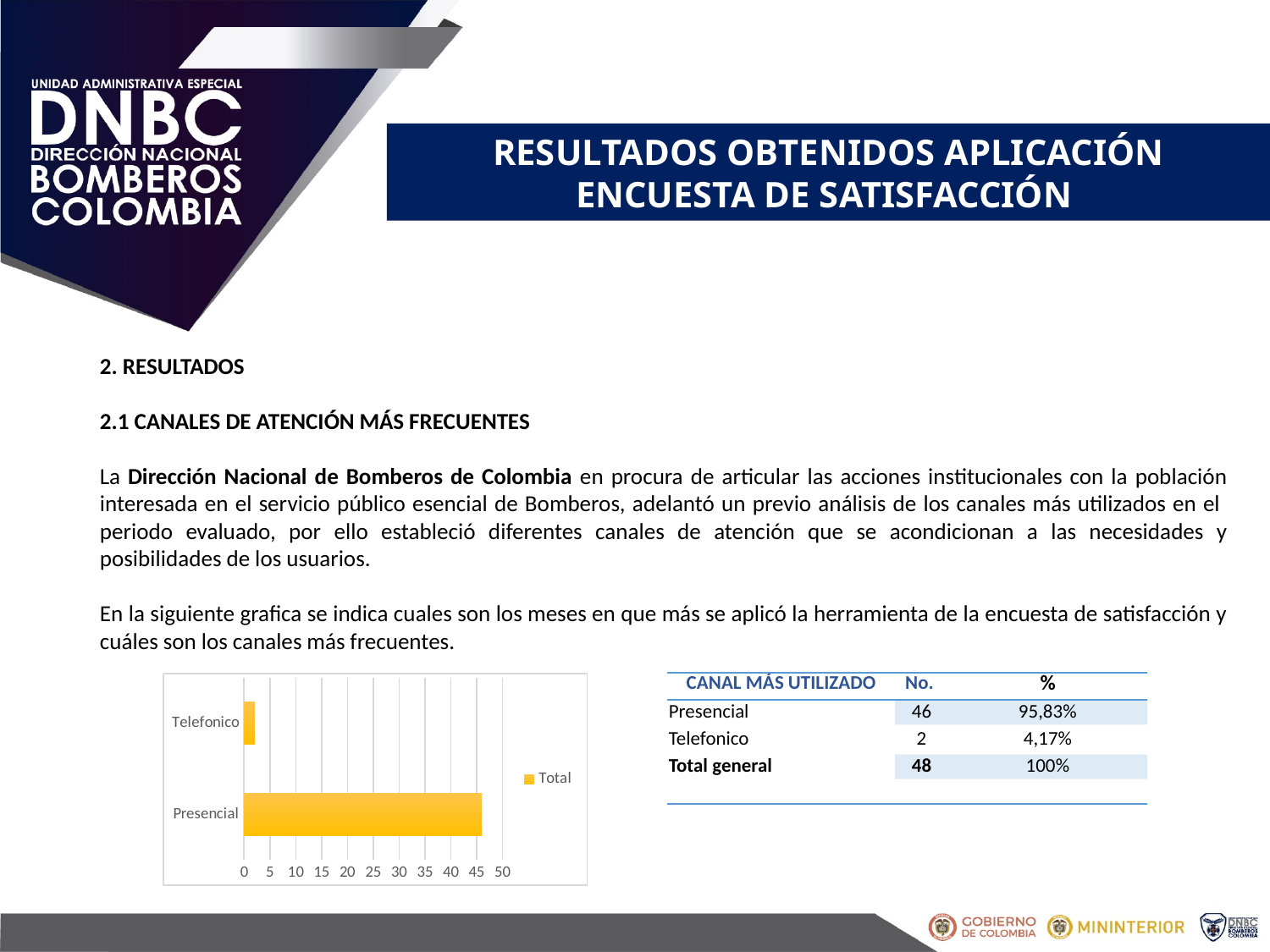
What is the highest value shown on the chart's horizontal axis? 50 Which category has the highest value in the chart? Presencial Which category has the lowest value in the chart? Telefonico What colour are the bars in the chart? yellow What kind of chart is shown on the slide? bar chart Is the value for Telefonico greater or less than 5? less Is the value for Presencial greater or less than 40? greater Is the value for Presencial greater or less than 50? less How many series does the chart legend list? 1 What is the name of the series shown in the chart legend? Total Which is larger in the chart, the value for Presencial or the value for Telefonico? Presencial How many categories are plotted in the chart? 2